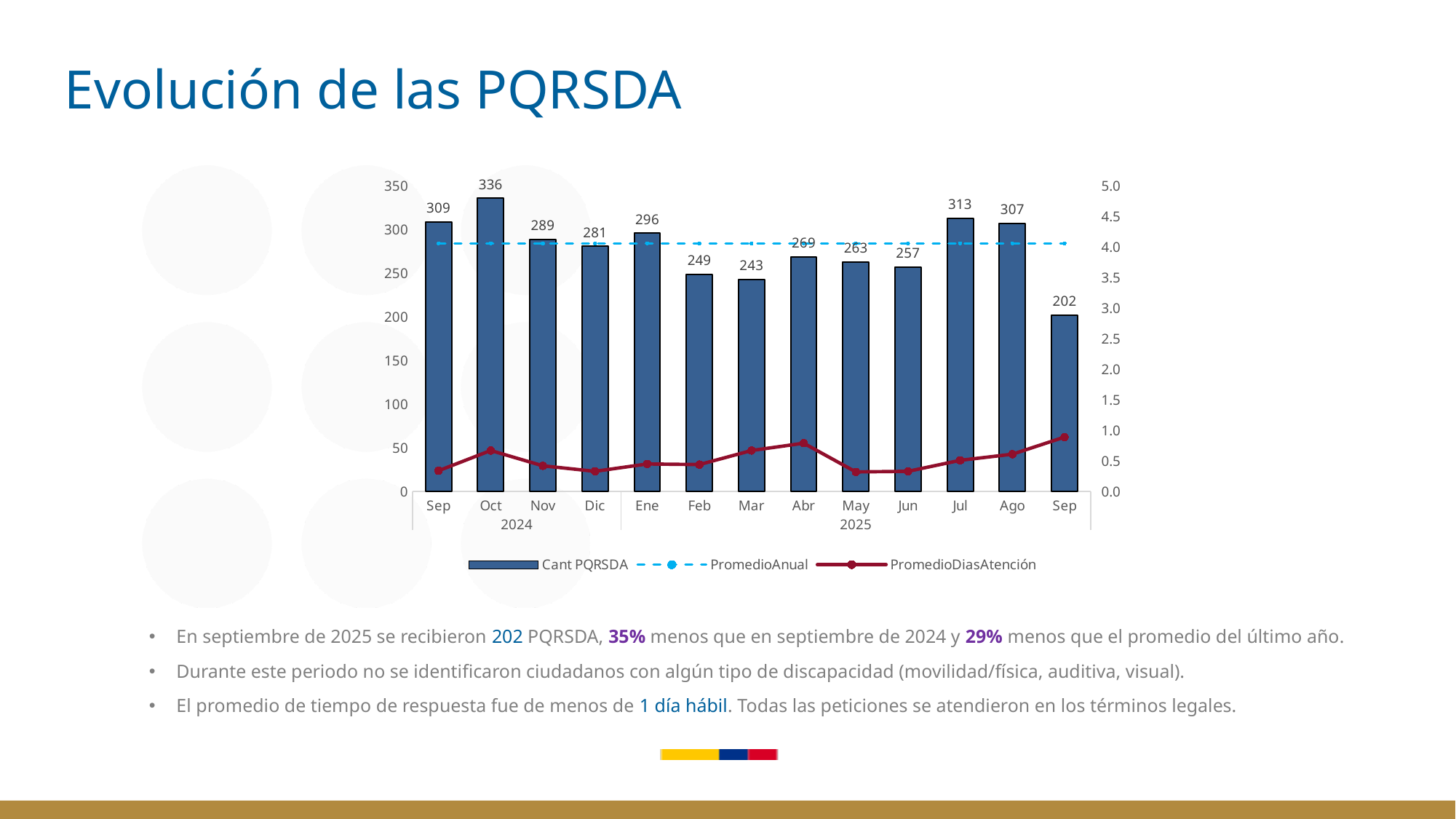
What kind of chart is shown on the slide? Combined bar and line chart What is the title of the slide containing the chart? Evolución de las PQRSDA How many series does the legend list? 3 Which is larger, the Cant PQRSDA value for Jul 2025 or for Ago 2025? Jul 2025 Is the PromedioDiasAtención value for Abr 2025 greater or less than 1.0? less What is the Cant PQRSDA value for Mar 2025? 243 What is the Cant PQRSDA value for Sep 2025? 202 Which month has the highest Cant PQRSDA value? Oct 2024 How many months are shown on the x axis of the chart? 13 What is the Cant PQRSDA value for Oct 2024? 336 Which month has the lowest Cant PQRSDA value? Sep 2025 What is the difference between the Cant PQRSDA values for Sep 2024 and Sep 2025? 107